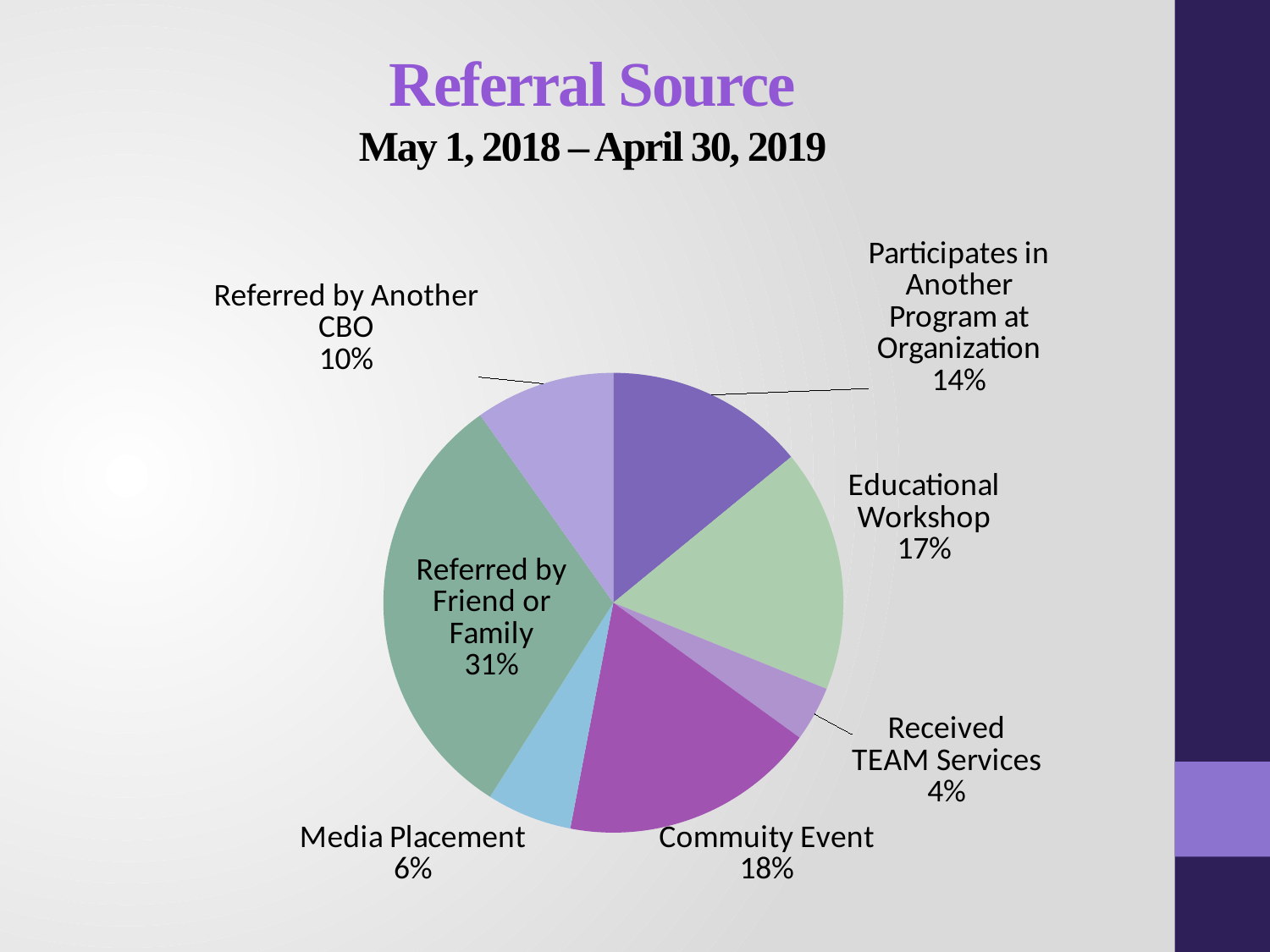
What is the difference in percentage points between Commuity Event and Media Placement? 12 Which referral source has the smallest share of the pie? Received TEAM Services What percentage is shown for Received TEAM Services? 4% What share of referrals came from Referred by Friend or Family? 31% Which referral source has the largest share of the pie? Referred by Friend or Family How many slices does the pie chart have? 7 What date range does the chart cover, according to the subtitle? May 1, 2018 – April 30, 2019 What is the combined share of Referred by Friend or Family and Referred by Another CBO? 41% What percentage is shown for Participates in Another Program at Organization? 14% Which is larger, the share for Educational Workshop or the share for Referred by Another CBO? Educational Workshop What percentage is shown for Educational Workshop? 17% What kind of chart is shown on the slide? pie chart